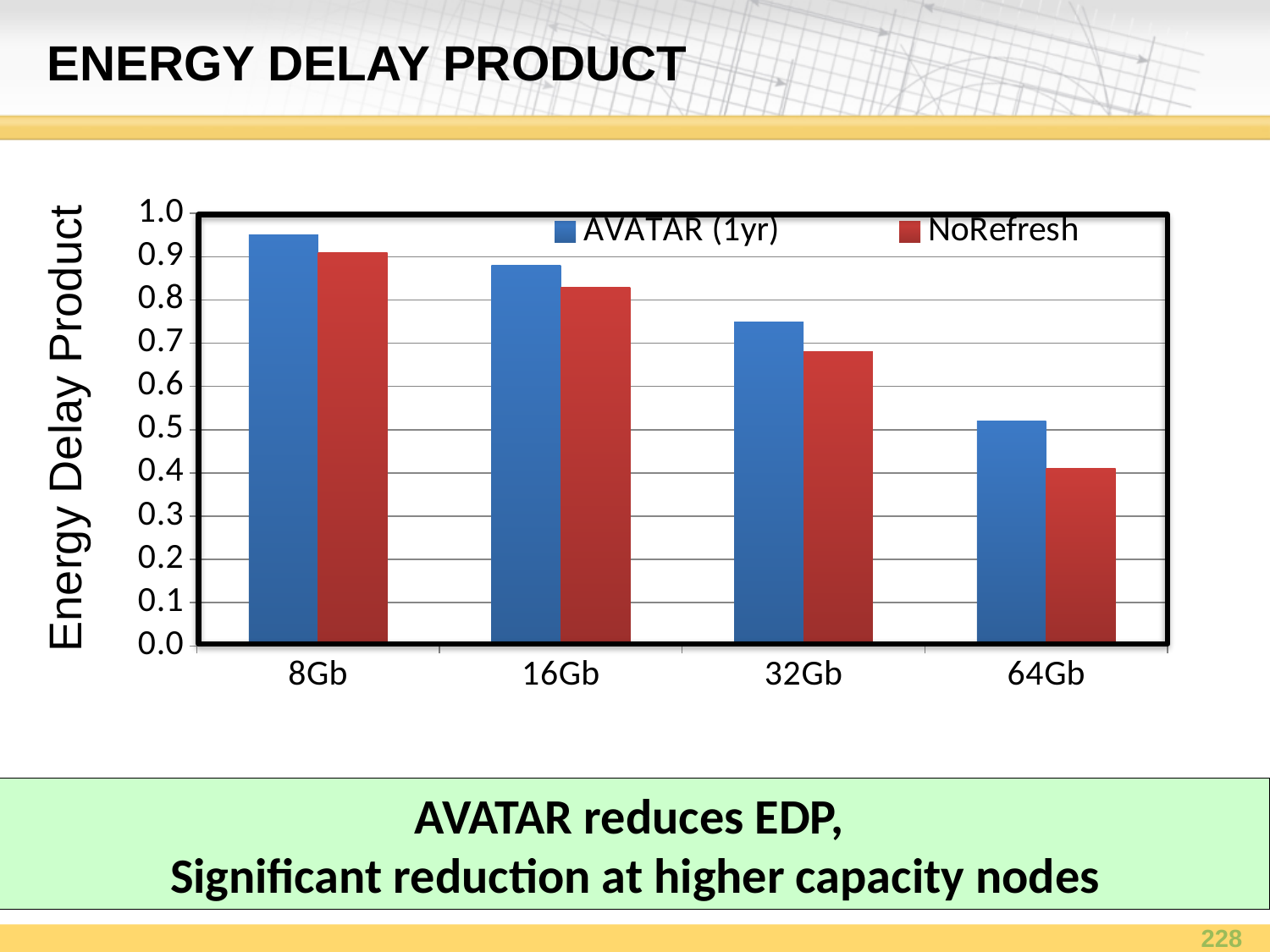
How many capacity categories are shown on the x axis? 4 What kind of chart is shown on the slide? bar chart How many series does the legend list? 2 Is the AVATAR (1yr) value for 32Gb greater or less than 0.7? greater Which series is shown in blue? AVATAR (1yr) For which capacity is the NoRefresh value lowest? 64Gb What is the label of the vertical axis? Energy Delay Product Do the AVATAR (1yr) values rise or fall as capacity increases from 8Gb to 64Gb? fall Is the AVATAR (1yr) value for 8Gb greater or less than 0.9? greater At 64Gb, which is larger: AVATAR (1yr) or NoRefresh? AVATAR (1yr) Is the NoRefresh value for 64Gb greater or less than 0.5? less For which capacity is the AVATAR (1yr) value highest? 8Gb